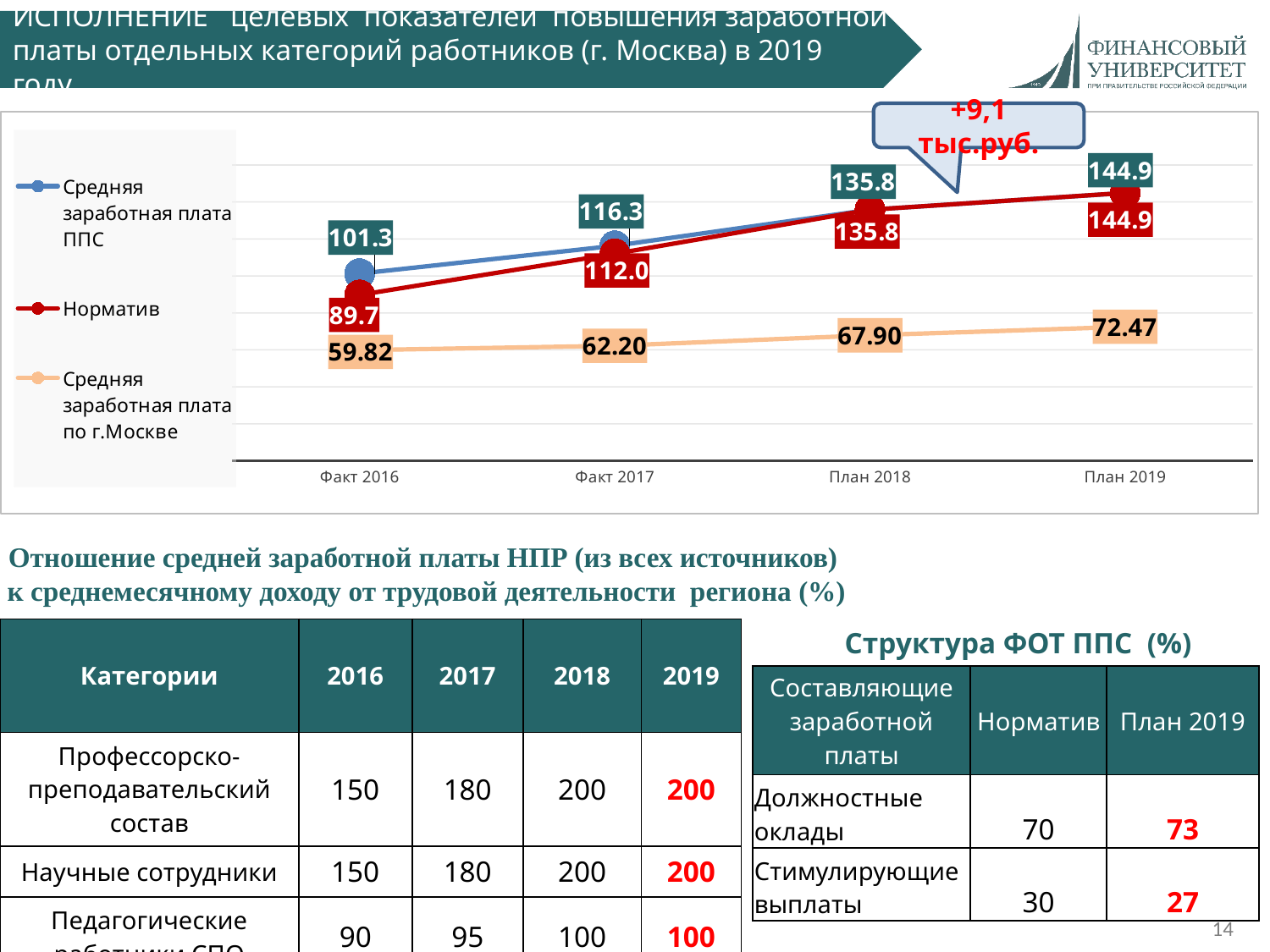
In which category is Средняя заработная плата ППС the highest? План 2019 Which is larger for Факт 2017: Средняя заработная плата ППС or Средняя заработная плата по г.Москве? Средняя заработная плата ППС What is the value of Средняя заработная плата по г.Москве for План 2018? 67.90 What is the value of Норматив for Факт 2017? 112.0 What is the value of Средняя заработная плата по г.Москве for План 2019? 72.47 What type of chart is shown on the slide? line chart What is the value of Средняя заработная плата ППС for Факт 2016? 101.3 Do the values of Средняя заработная плата по г.Москве rise or fall from Факт 2016 to План 2019? rise In which category is Норматив the lowest? Факт 2016 What is the difference between Средняя заработная плата ППС and Норматив for Факт 2016? 11.6 How many categories are shown on the x axis of the chart? 4 How many series does the chart legend list? 3